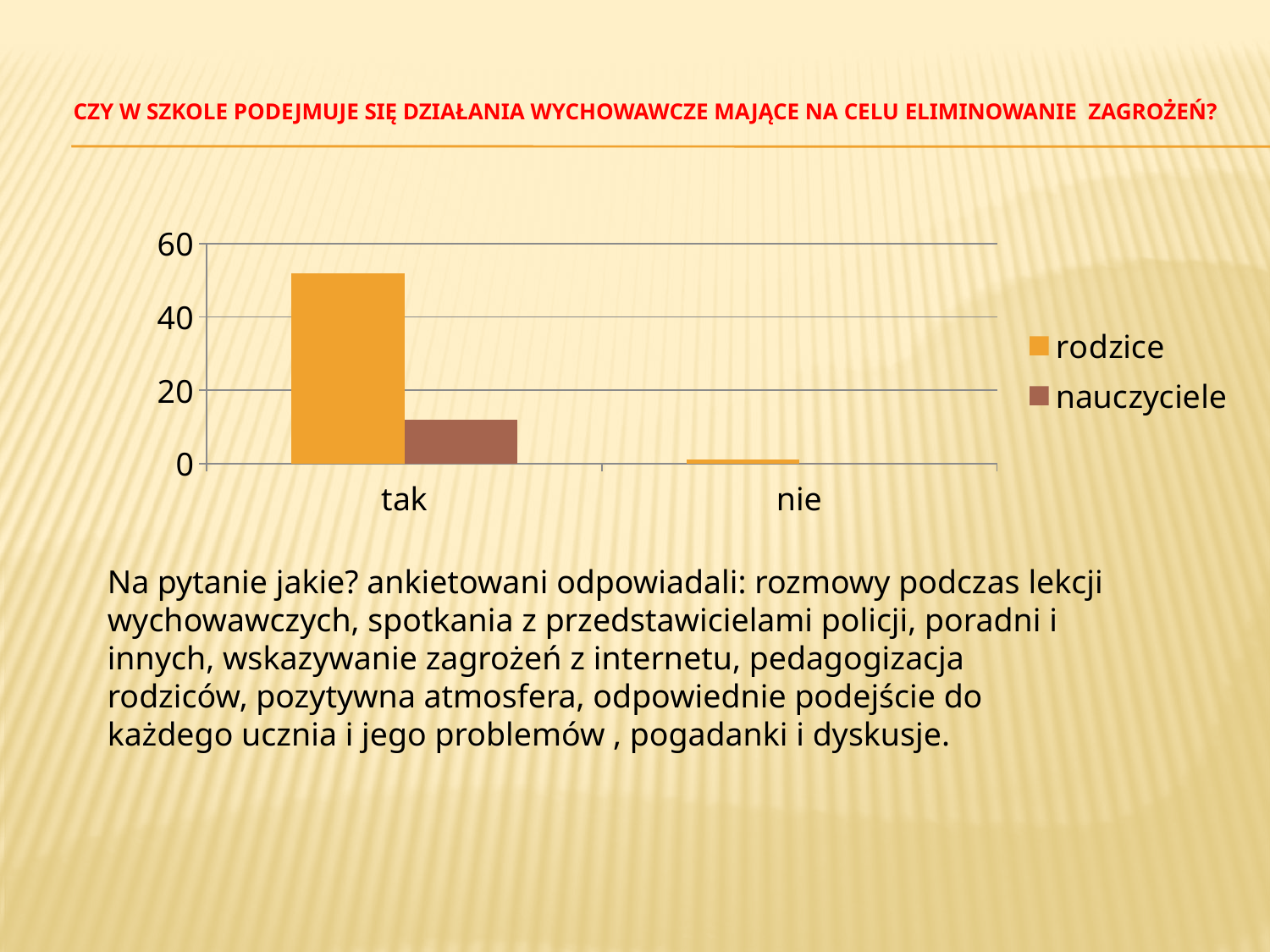
Which category has the highest value for the rodzice series? tak Is the value for rodzice in the category tak greater or less than 40? greater Which series are listed in the chart's legend? rodzice, nauczyciele Which series is shown in orange in the chart? rodzice How many series does the chart's legend list? 2 How many categories are shown on the x axis of the chart? 2 Which category has the lowest value for the rodzice series? nie Is the value for rodzice in the category tak greater or less than 60? less What kind of chart is shown on the slide? bar chart Is the value for rodzice in the category nie greater or less than 20? less For the category tak, which series has the larger value, rodzice or nauczyciele? rodzice